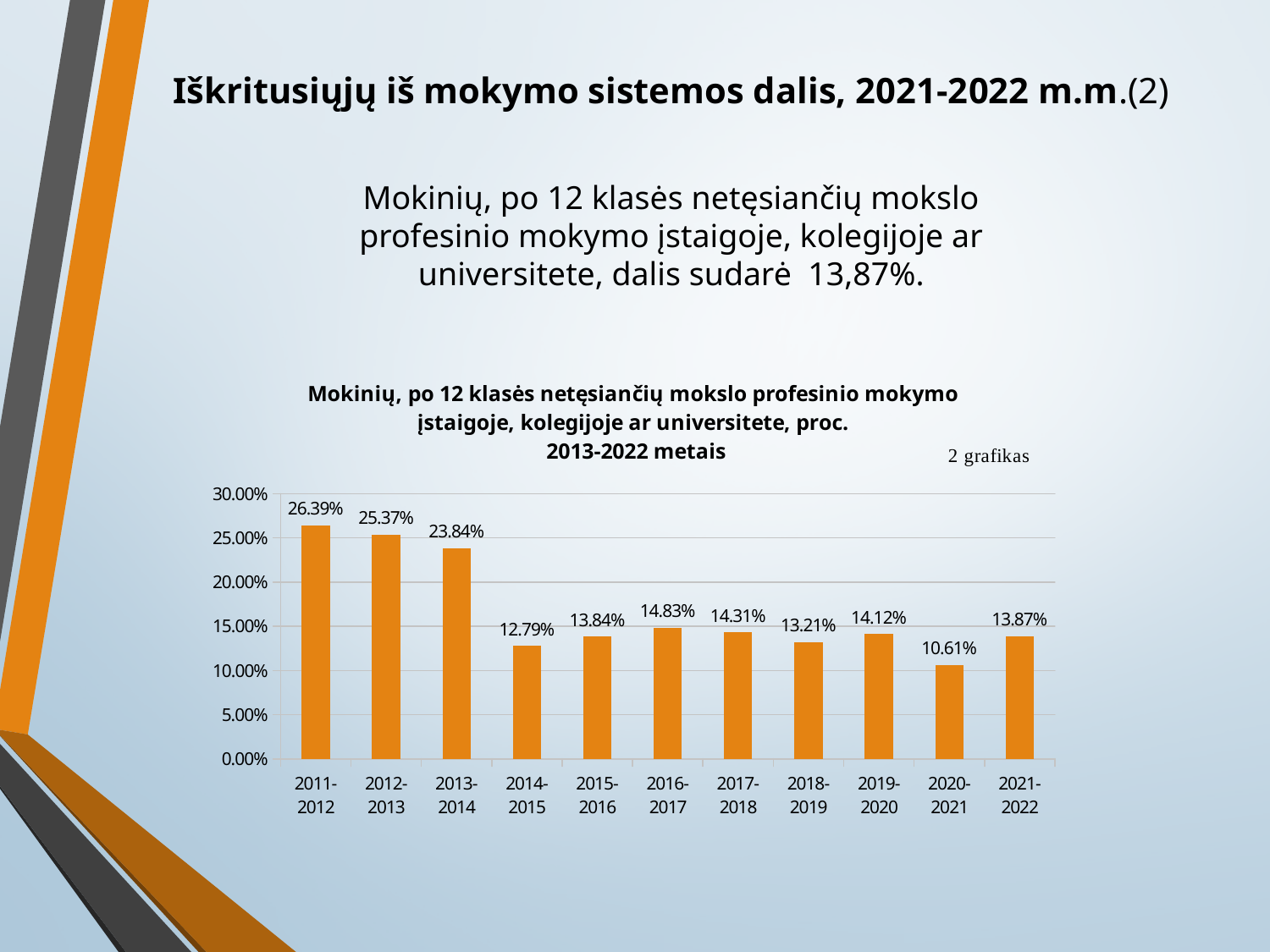
Which school year has the lowest value? 2020-2021 What is the value for 2021-2022? 13.87% Which school year has the highest value? 2011-2012 What is the difference between the values for 2021-2022 and 2020-2021? 3.26% What is the highest value shown on the y axis? 30.00% What is the value for 2014-2015? 12.79% How many school years are shown on the x axis? 11 Which is larger, the value for 2012-2013 or the value for 2013-2014? 2012-2013 What is the difference between the values for 2011-2012 and 2020-2021? 15.78% Is the value for 2018-2019 greater or less than 15.00%? less What is the value for 2016-2017? 14.83% What kind of chart is shown on the slide? bar chart